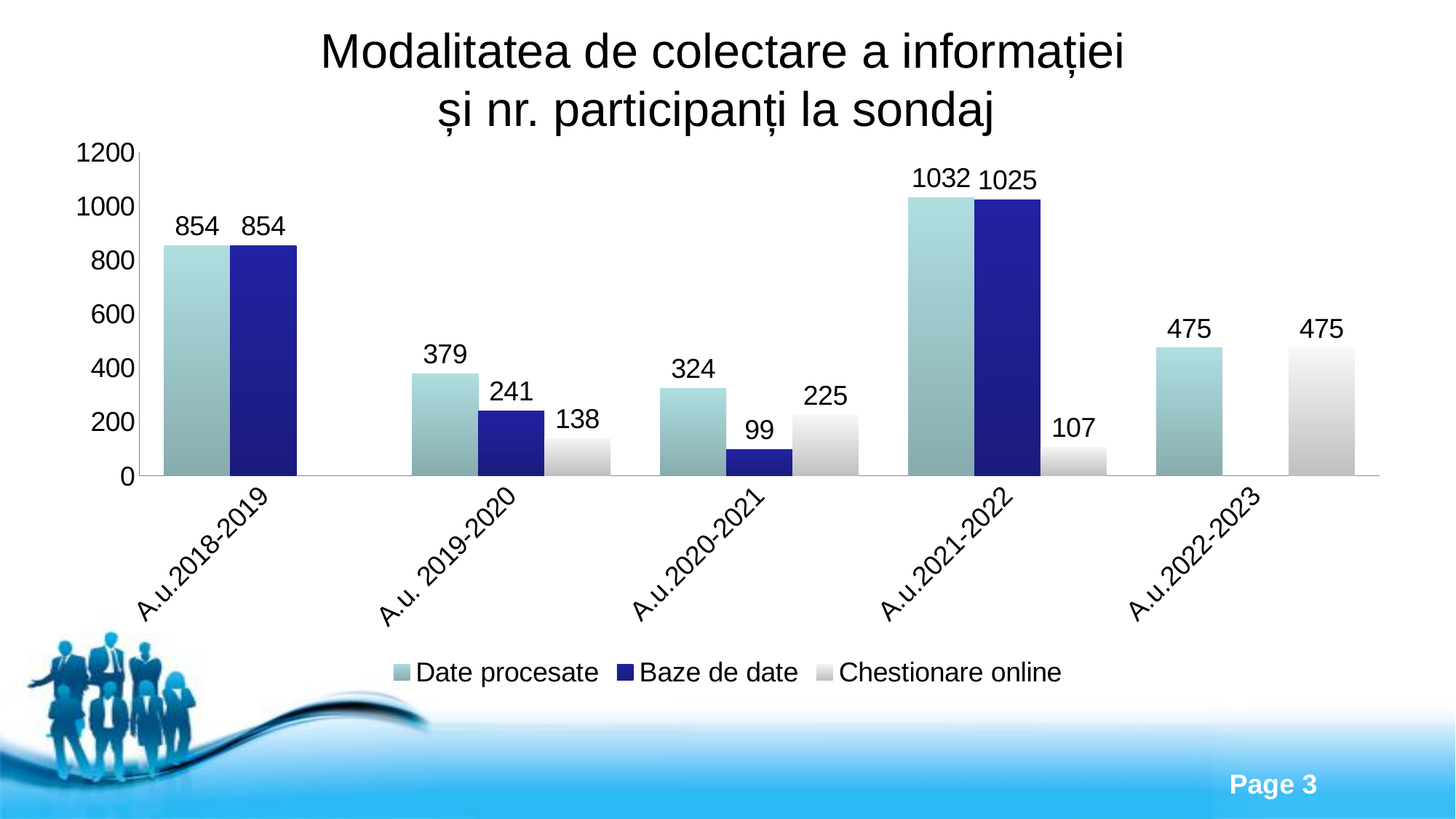
Which category has the highest value for Date procesate? A.u.2021-2022 What is the difference between Date procesate and Baze de date for A.u.2020-2021? 225 What is the value of Date procesate for A.u.2021-2022? 1032 Which is larger for A.u. 2019-2020: Baze de date or Chestionare online? Baze de date What is the value of Baze de date for A.u. 2019-2020? 241 How many categories are shown on the x axis? 5 Which category has the lowest value for Baze de date among those where it is plotted? A.u.2020-2021 What is the difference between Date procesate for A.u.2021-2022 and A.u.2022-2023? 557 Which series is shown in dark blue in the legend? Baze de date How many series does the legend list? 3 What is the value of Chestionare online for A.u.2020-2021? 225 What kind of chart is shown on the slide? Bar chart